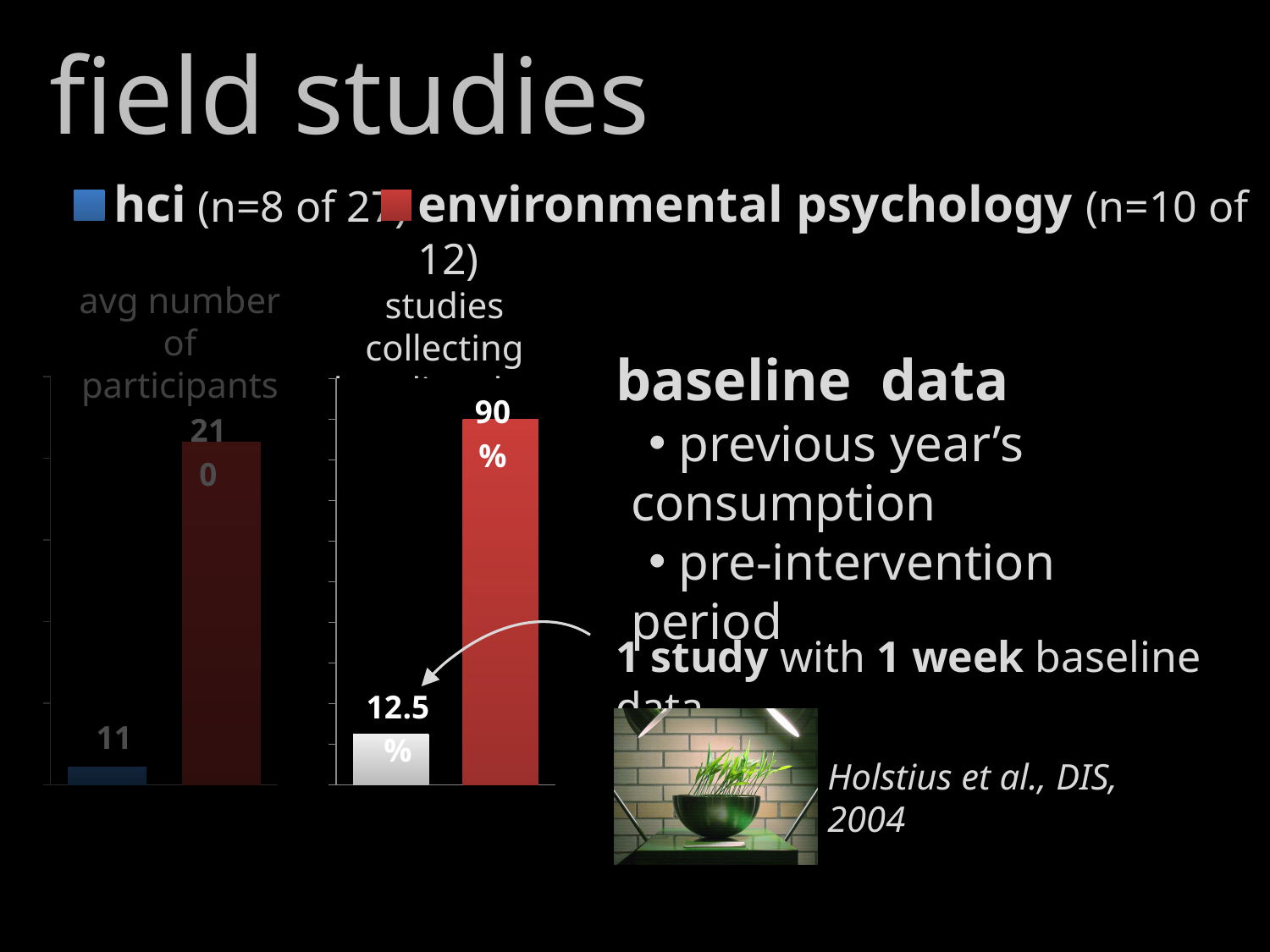
In the 'studies collecting' chart on the right, what is the value for environmental psychology? 90% In the 'avg number of participants' chart on the left, what is the value for environmental psychology? 210 How many bars are plotted in the 'studies collecting' chart on the right? 2 How many series does the legend list for the charts on the slide? 2 In the 'avg number of participants' chart on the left, which field has the higher average number of participants? environmental psychology In the 'avg number of participants' chart on the left, what is the value for hci? 11 In the 'studies collecting' chart on the right, which field has the lower value? hci According to the legend, what colour represents hci in the charts? blue In the 'studies collecting' chart on the right, what is the value for hci? 12.5% In the 'avg number of participants' chart on the left, what is the difference between the environmental psychology value and the hci value? 199 What kind of chart is the 'avg number of participants' chart on the left? bar chart In the 'studies collecting' chart on the right, what is the difference between the environmental psychology value and the hci value? 77.5%